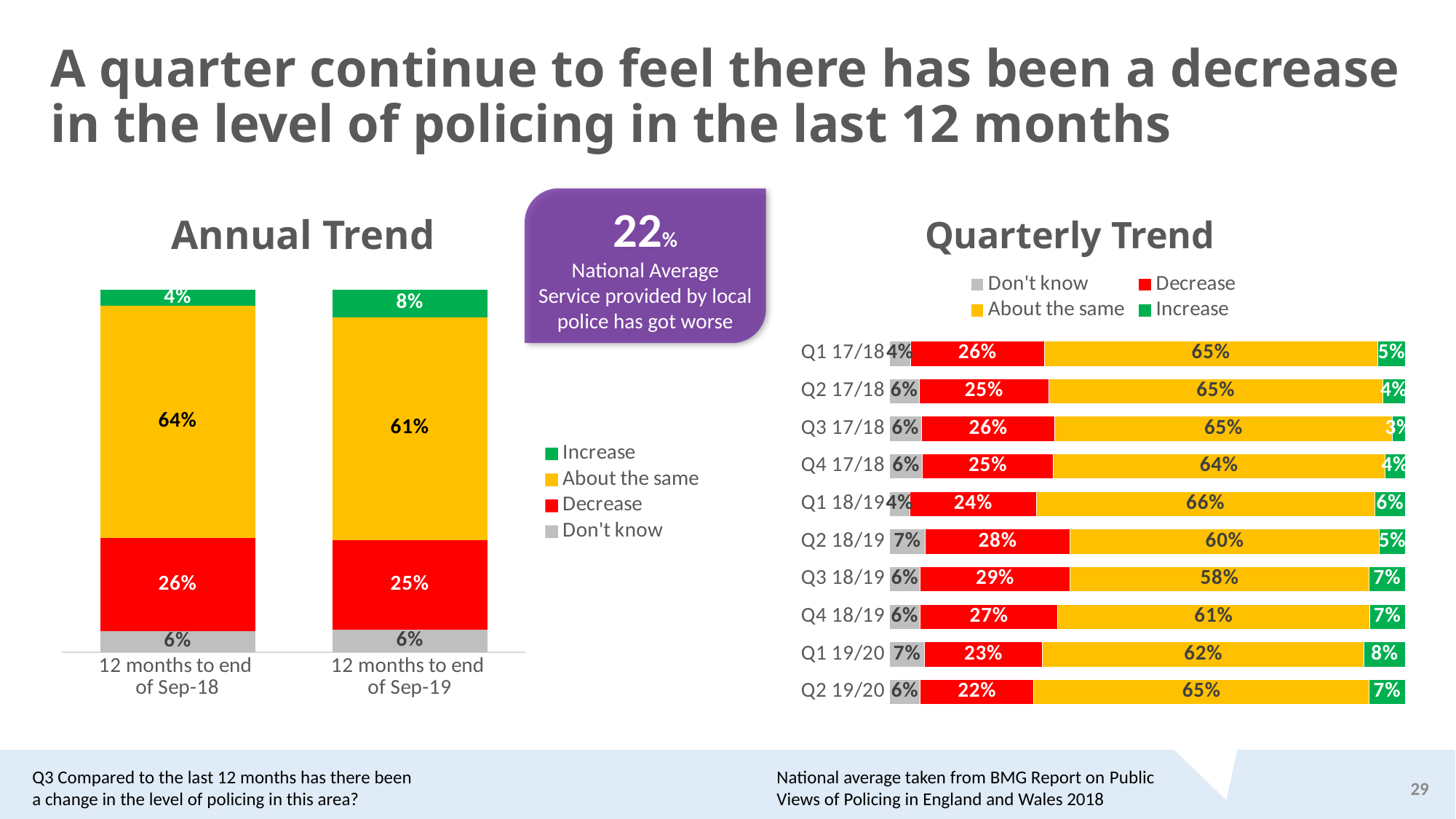
What national average figure is shown in the purple box on the slide? 22% In the Quarterly Trend chart, which quarter has the lowest 'Decrease' percentage? Q2 19/20 In the Annual Trend chart, what percentage said 'Decrease' for 12 months to end of Sep-19? 25% In the Quarterly Trend chart, what percentage said 'About the same' in Q2 18/19? 60% In the Quarterly Trend chart, how many quarters are shown? 10 In the Quarterly Trend chart, what percentage said 'Decrease' in Q3 18/19? 29% In the Annual Trend chart, how many series does the legend list? 4 What kind of chart is the Quarterly Trend chart? Stacked bar chart In the Quarterly Trend chart, is the 'Increase' percentage larger in Q1 19/20 or Q3 17/18? Q1 19/20 In the Quarterly Trend chart, which quarter has the highest 'Decrease' percentage? Q3 18/19 In the Annual Trend chart, what percentage said 'Increase' for 12 months to end of Sep-18? 4% In the Annual Trend chart, what is the difference in the 'About the same' share between 12 months to end of Sep-18 and 12 months to end of Sep-19? 3 percentage points